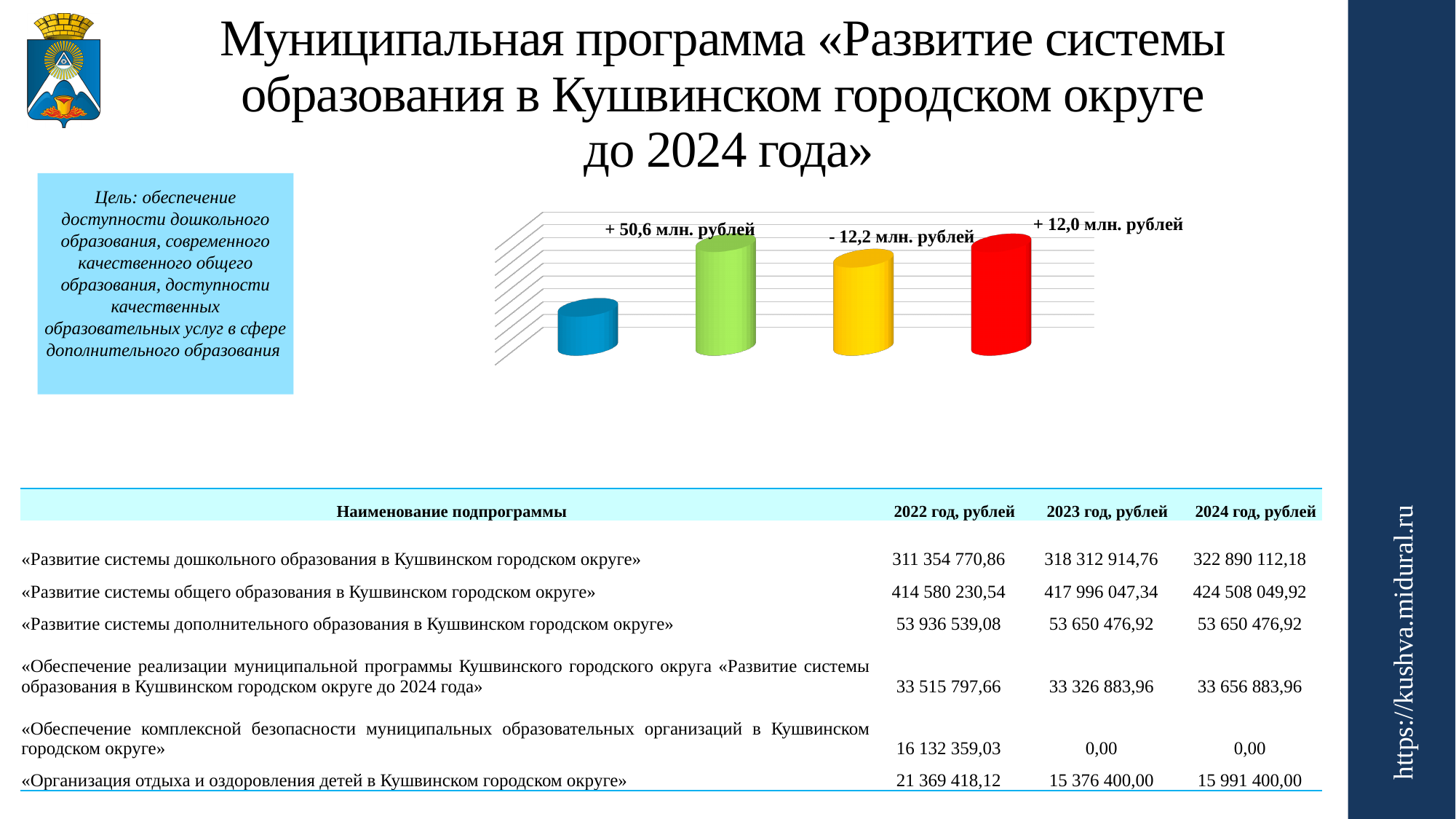
How many bars does the chart contain? 4 What label is printed above the red bar in the chart? + 12,0 млн. рублей How many bars in the chart have a text label printed above them? 3 What colour is the first (leftmost) bar in the chart? blue What kind of chart is shown on the slide? bar chart Which is taller in the chart, the red bar or the yellow bar? the red bar What label is printed above the green bar in the chart? + 50,6 млн. рублей Which bar in the chart is the shortest? the blue bar What label is printed above the yellow bar in the chart? - 12,2 млн. рублей Which is taller in the chart, the blue bar or the yellow bar? the yellow bar